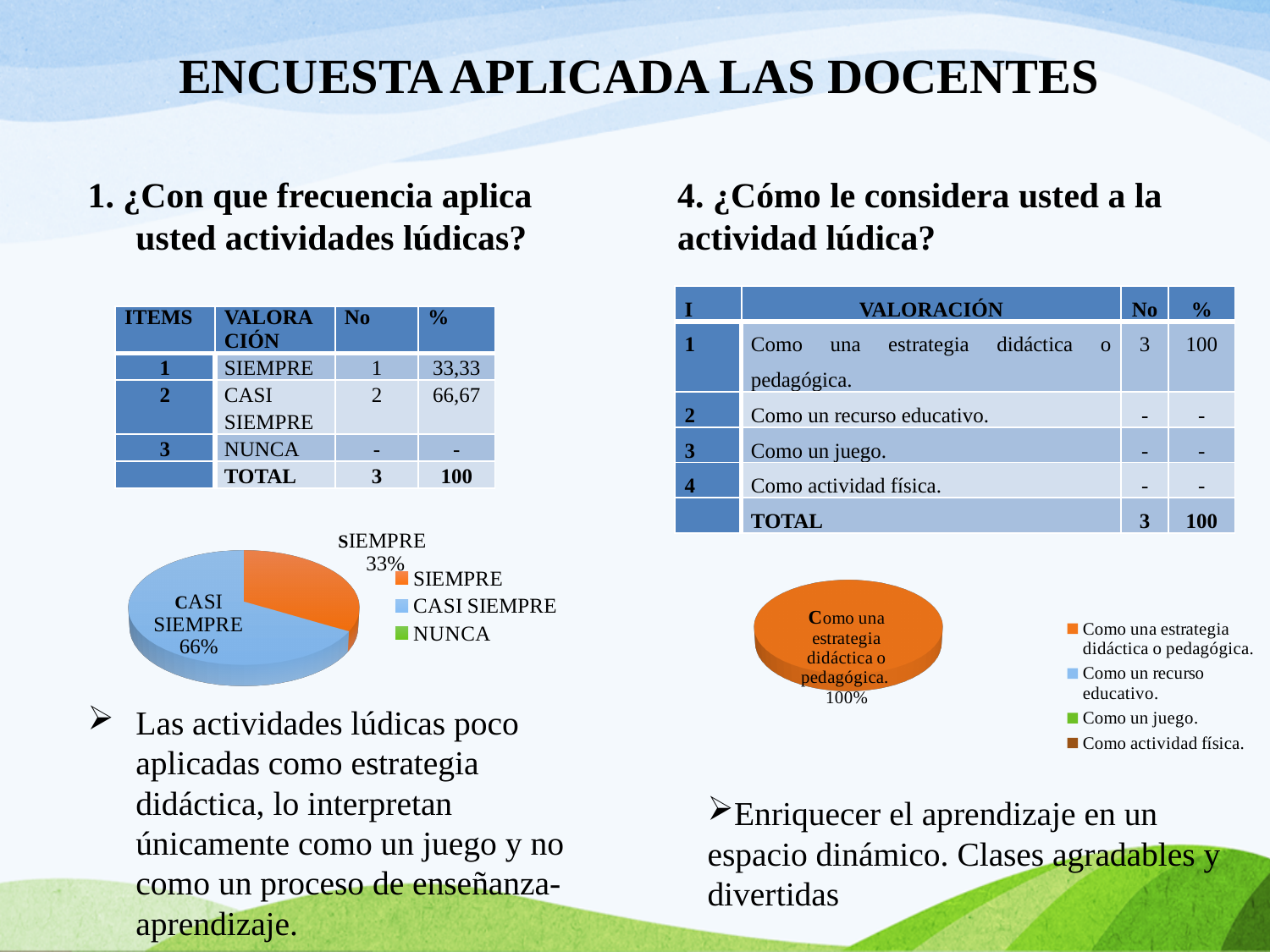
On the right pie chart, which category makes up the whole pie? Como una estrategia didáctica o pedagógica On the left pie chart, what share is labelled for SIEMPRE? 33% What type of chart is shown on the right side of the slide? Pie chart How many entries does the legend of the right pie chart list? 4 What type of chart is shown on the left side of the slide? Pie chart On the left pie chart, what colour is the CASI SIEMPRE slice? Blue How many entries does the legend of the left pie chart list? 3 On the left pie chart, what is the difference in percentage points between CASI SIEMPRE and SIEMPRE? 33 On the left pie chart, which is larger, SIEMPRE or CASI SIEMPRE? CASI SIEMPRE On the left pie chart, what share is labelled for CASI SIEMPRE? 66% On the left pie chart, which category has the largest slice? CASI SIEMPRE On the right pie chart, what share is labelled for 'Como una estrategia didáctica o pedagógica'? 100%